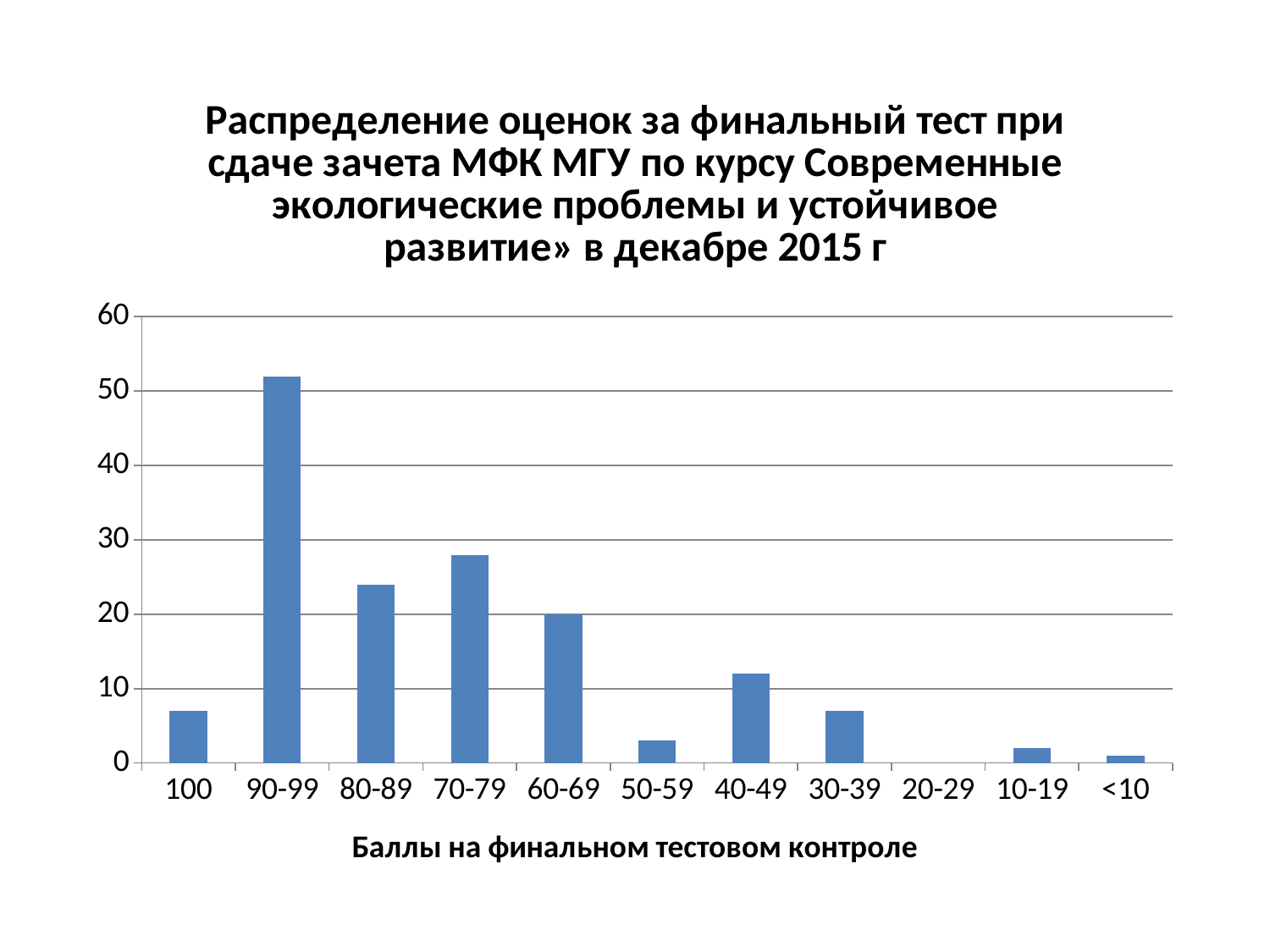
Which has a larger value, 40-49 or 30-39? 40-49 Which score range has the highest number of students? 90-99 Is the value for 80-89 greater or less than 20? greater What kind of chart is shown on the slide? bar chart Is the value for 100 greater or less than 10? less Is the value for 50-59 greater or less than 10? less What is the x-axis title of the chart? Баллы на финальном тестовом контроле Which score range has the lowest value (no bar at all)? 20-29 Which has a larger value, 70-79 or 80-89? 70-79 How many score categories are shown on the x axis? 11